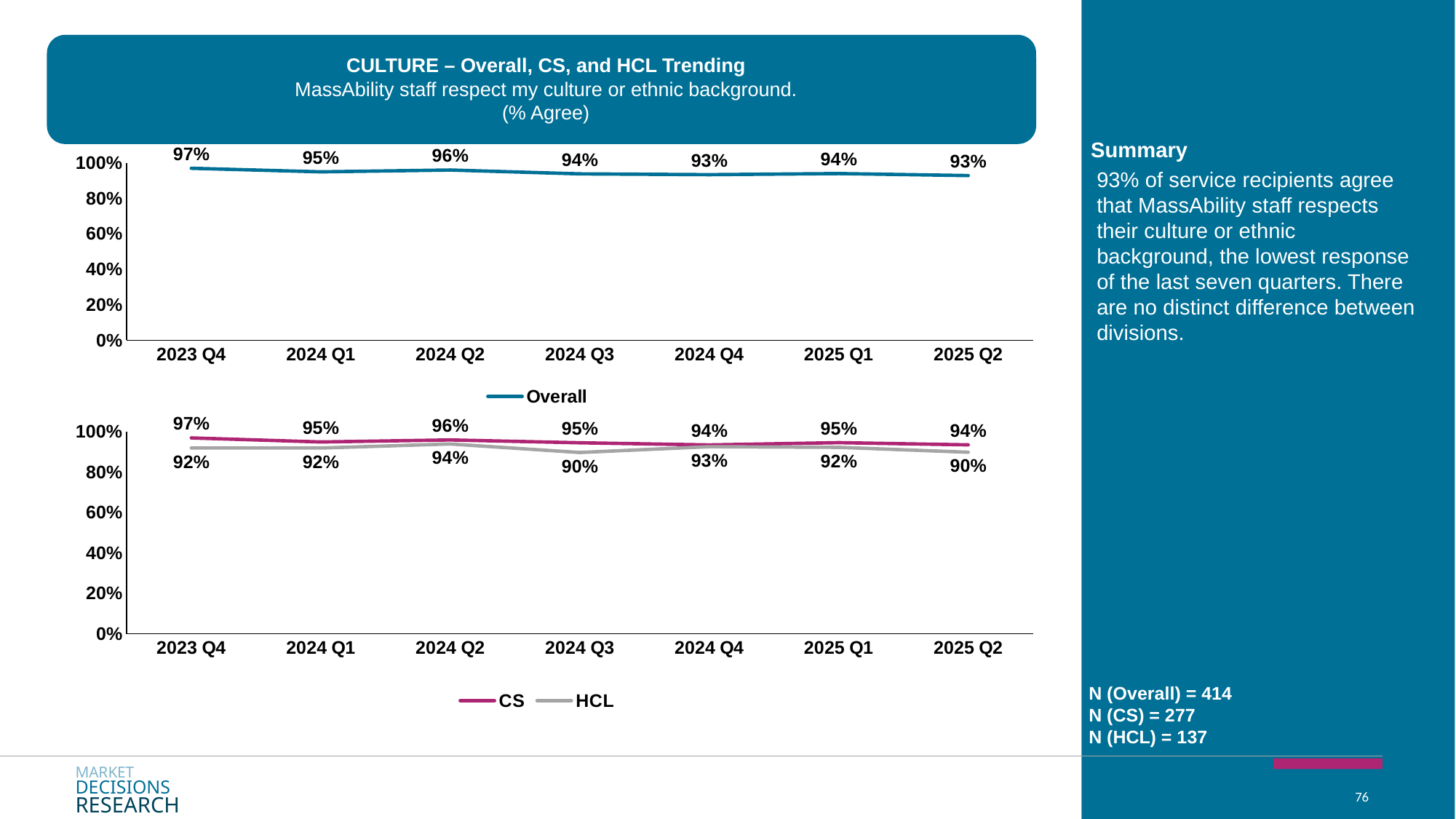
In the top chart (Overall), what is the value for 2023 Q4? 97% In the bottom chart, what is the difference between CS and HCL in 2024 Q3? 5% In the top chart (Overall), which quarter has the highest value? 2023 Q4 In the bottom chart, what is the HCL value for 2025 Q2? 90% How many series does the legend of the bottom chart list? 2 In the bottom chart, which is larger in 2025 Q1, CS or HCL? CS In the top chart (Overall), how many quarters are plotted? 7 In the top chart (Overall), what is the value for 2025 Q2? 93% What type of chart is the top chart? Line chart In the bottom chart, which quarter has the lowest HCL value? 2024 Q3 and 2025 Q2 In the top chart (Overall), what is the difference between the 2023 Q4 value and the 2025 Q2 value? 4% In the bottom chart, what is the CS value for 2024 Q3? 95%